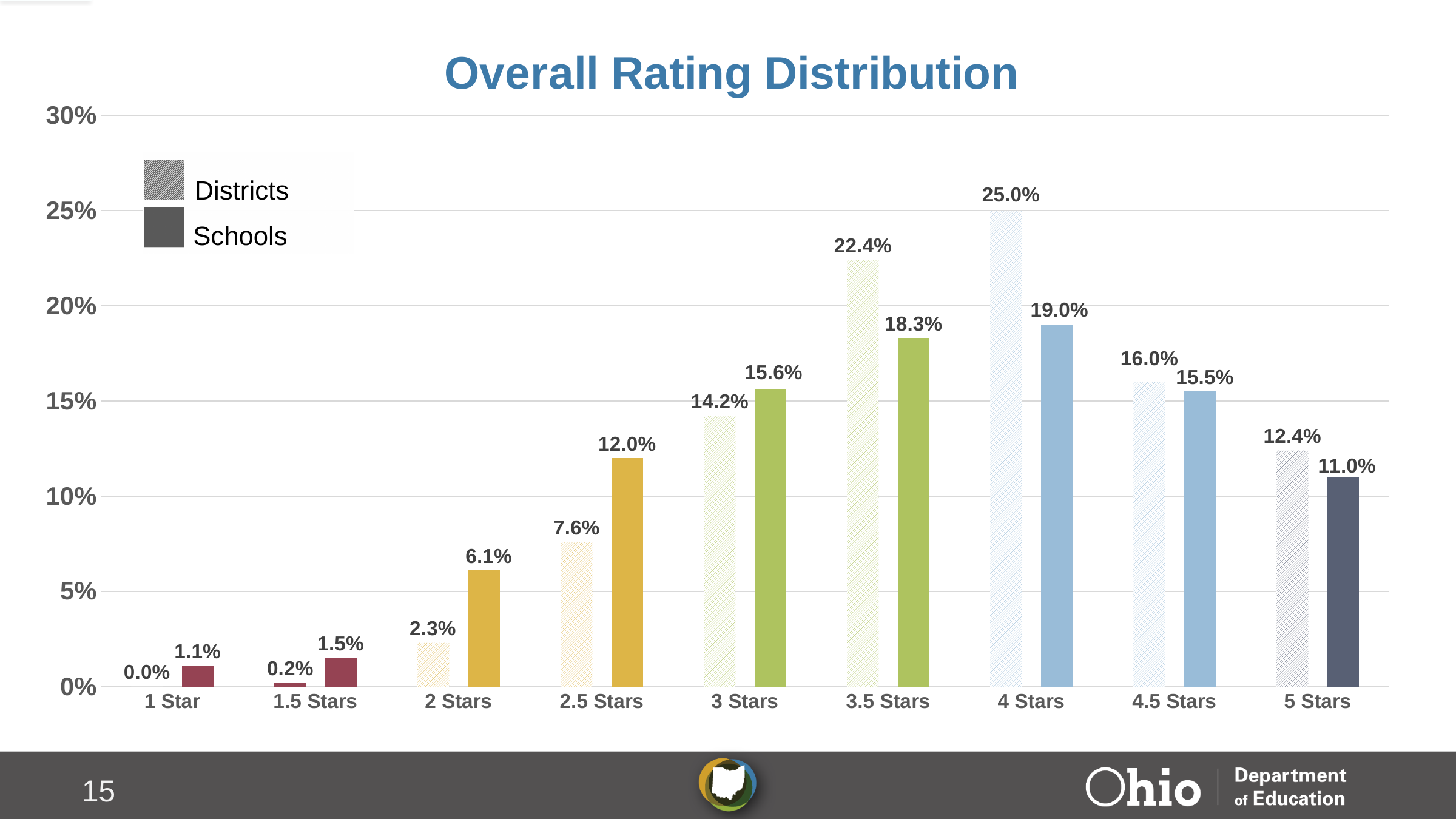
What is the title of the chart? Overall Rating Distribution What kind of chart is shown on the slide? Bar chart Is the Districts value for 4.5 Stars greater or less than 15%? greater What is the Districts value for 1 Star? 0.0% Which rating category has the lowest Districts value? 1 Star What is the difference between the Districts and Schools values for 3.5 Stars? 4.1% What is the Schools value for 3.5 Stars? 18.3% How many series does the legend list? 2 Which rating category has the highest Schools value? 4 Stars Which is larger for 3 Stars, the Districts value or the Schools value? Schools What is the Districts value for 4 Stars? 25.0% How many rating categories are shown on the x axis? 9